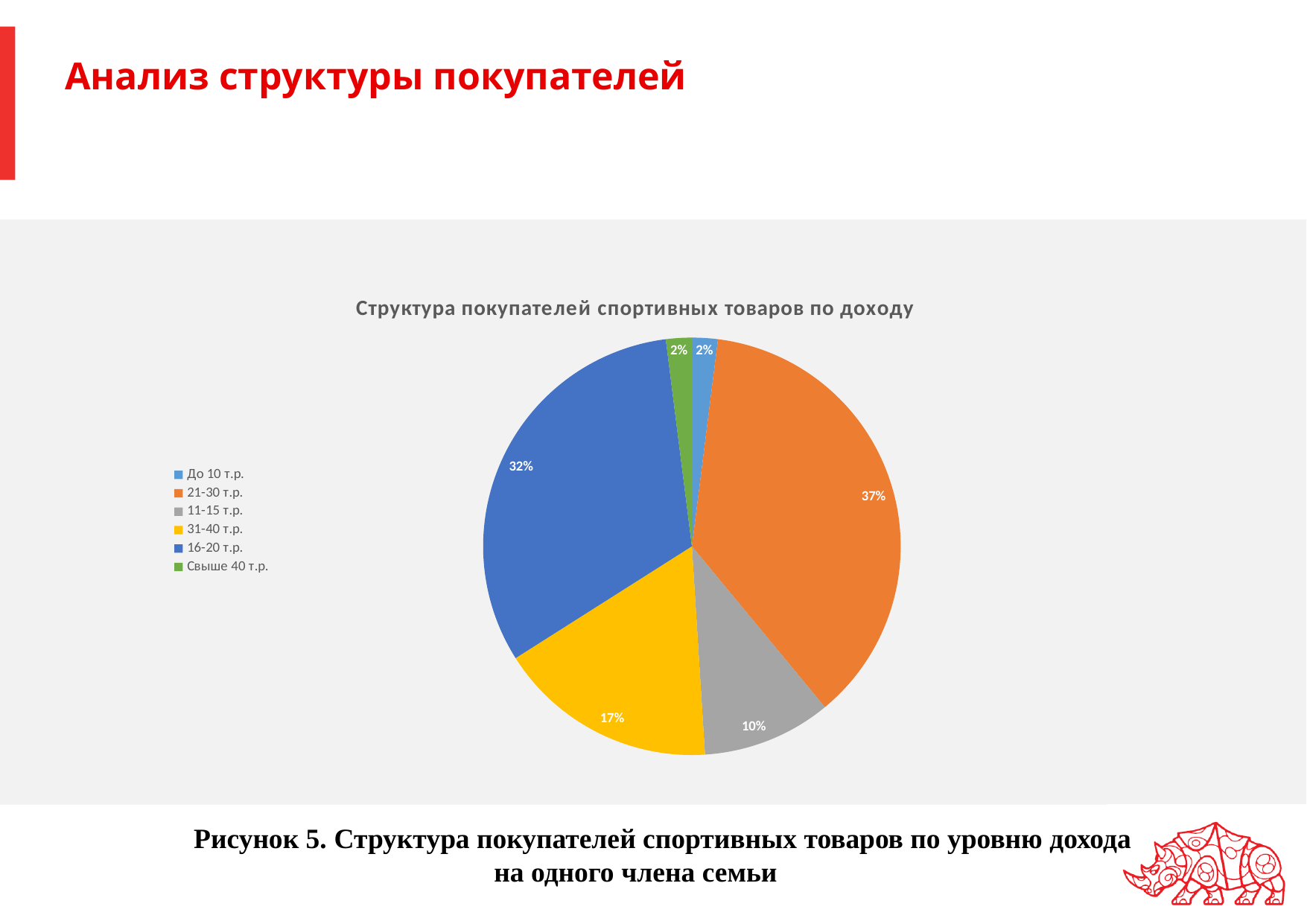
What is the difference in percentage points between the 21-30 т.р. share and the 16-20 т.р. share? 5% What share of the pie does the 16-20 т.р. category have? 32% Which income category has the largest share of the pie? 21-30 т.р. What colour is the slice for the 31-40 т.р. category? Yellow What kind of chart is shown on the slide? Pie chart What is the title of the chart? Структура покупателей спортивных товаров по доходу What share of the pie does the 31-40 т.р. category have? 17% What share of the pie does the Свыше 40 т.р. category have? 2% Which is larger, the share for 31-40 т.р. or the share for 11-15 т.р.? 31-40 т.р. How many categories does the legend of the pie chart list? 6